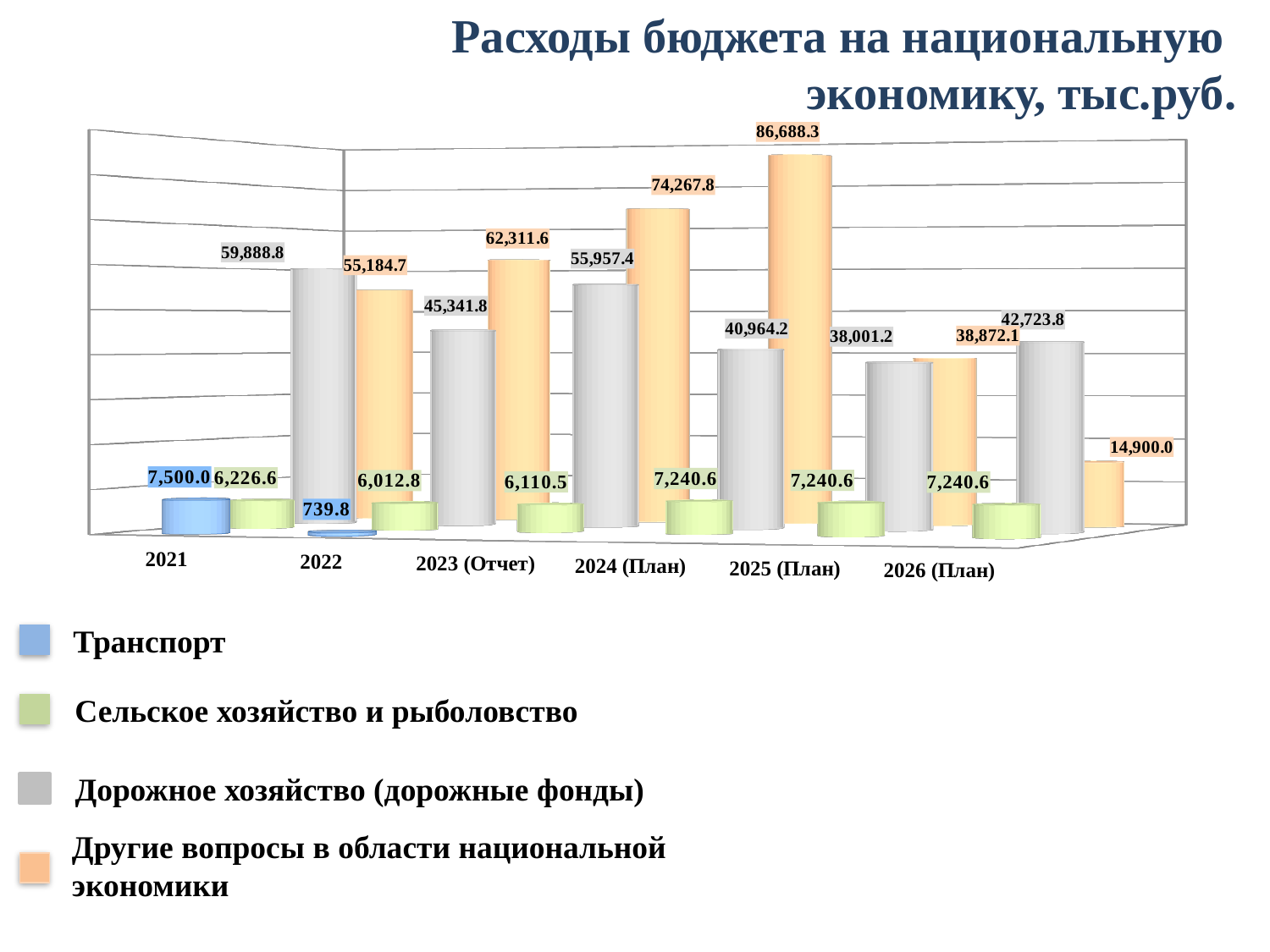
Which is larger, the Другие вопросы value of 86,688.3 or the Дорожное хозяйство value of 55,957.4? 86,688.3 What is the value for Транспорт in 2022? 739.8 How many year categories are shown on the x axis? 6 What is the lowest value shown for Другие вопросы в области национальной экономики? 14,900.0 What kind of chart is shown on the slide? bar chart How many series does the legend list? 4 What is the value for Транспорт in 2021? 7,500.0 What is the difference between the Транспорт values for 2021 and 2022? 6,760.2 What is the highest value shown for Другие вопросы в области национальной экономики? 86,688.3 What is the title of the chart? Расходы бюджета на национальную экономику, тыс.руб. What is the lowest value shown for Сельское хозяйство и рыболовство? 6,012.8 What is the highest value shown for Дорожное хозяйство (дорожные фонды)? 59,888.8